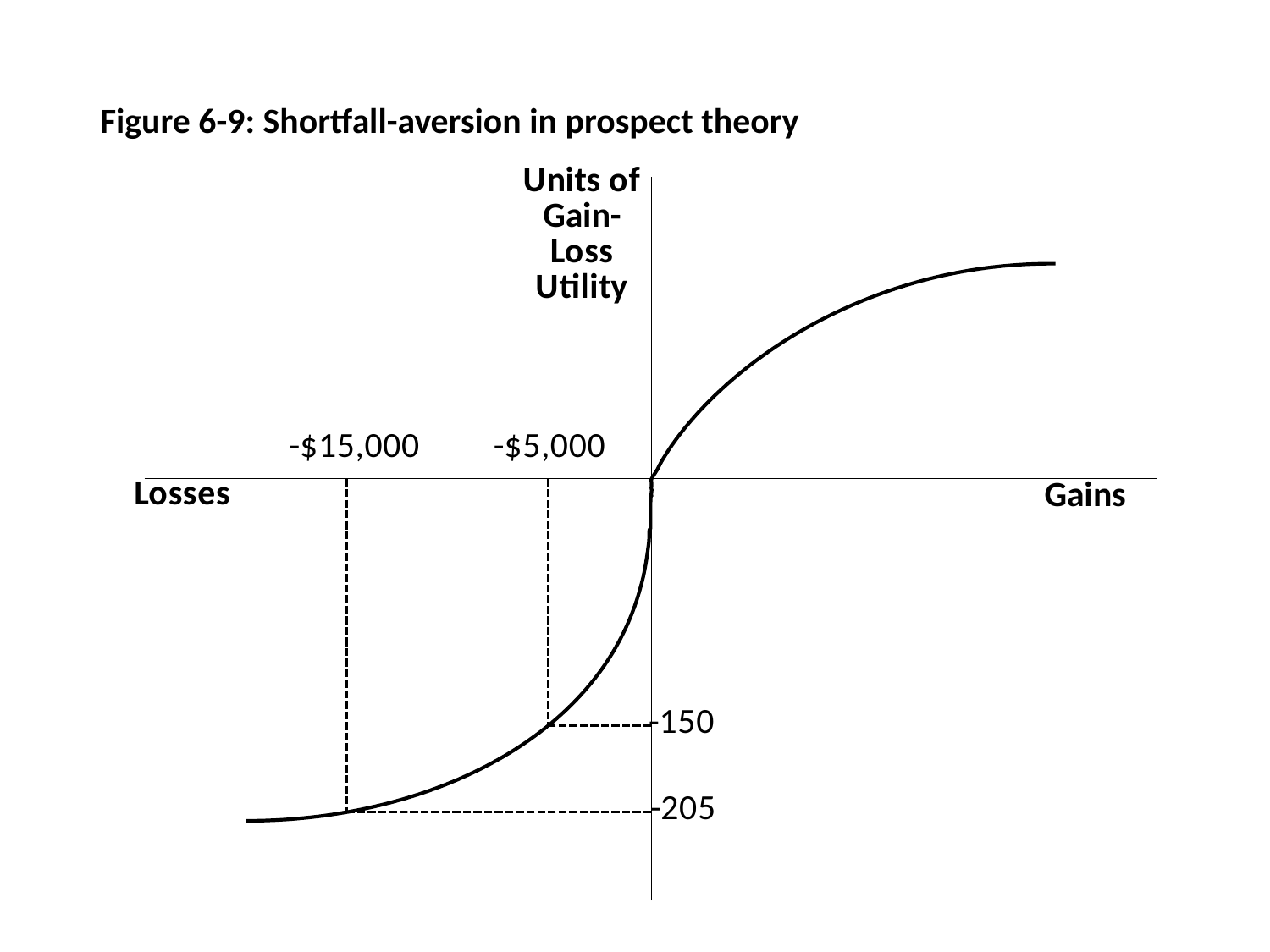
Which loss amount has the lower (more negative) gain-loss utility, -$5,000 or -$15,000? -$15,000 What is the gain-loss utility value marked for a loss of -$5,000? -150 What is the title of the figure? Figure 6-9: Shortfall-aversion in prospect theory Which of the two marked loss amounts has the lowest gain-loss utility? -$15,000 What is the gain-loss utility value marked for a loss of -$15,000? -205 How many loss amounts are marked with dashed lines on the horizontal axis? 2 What kind of chart is shown on the slide? Line chart What is the label of the vertical axis? Units of Gain-Loss Utility Which of the two marked loss amounts has the higher gain-loss utility? -$5,000 Does the curve rise or fall as you move from the Losses side to the Gains side? Rises What is the difference between the utility values marked for -$5,000 and -$15,000? 55